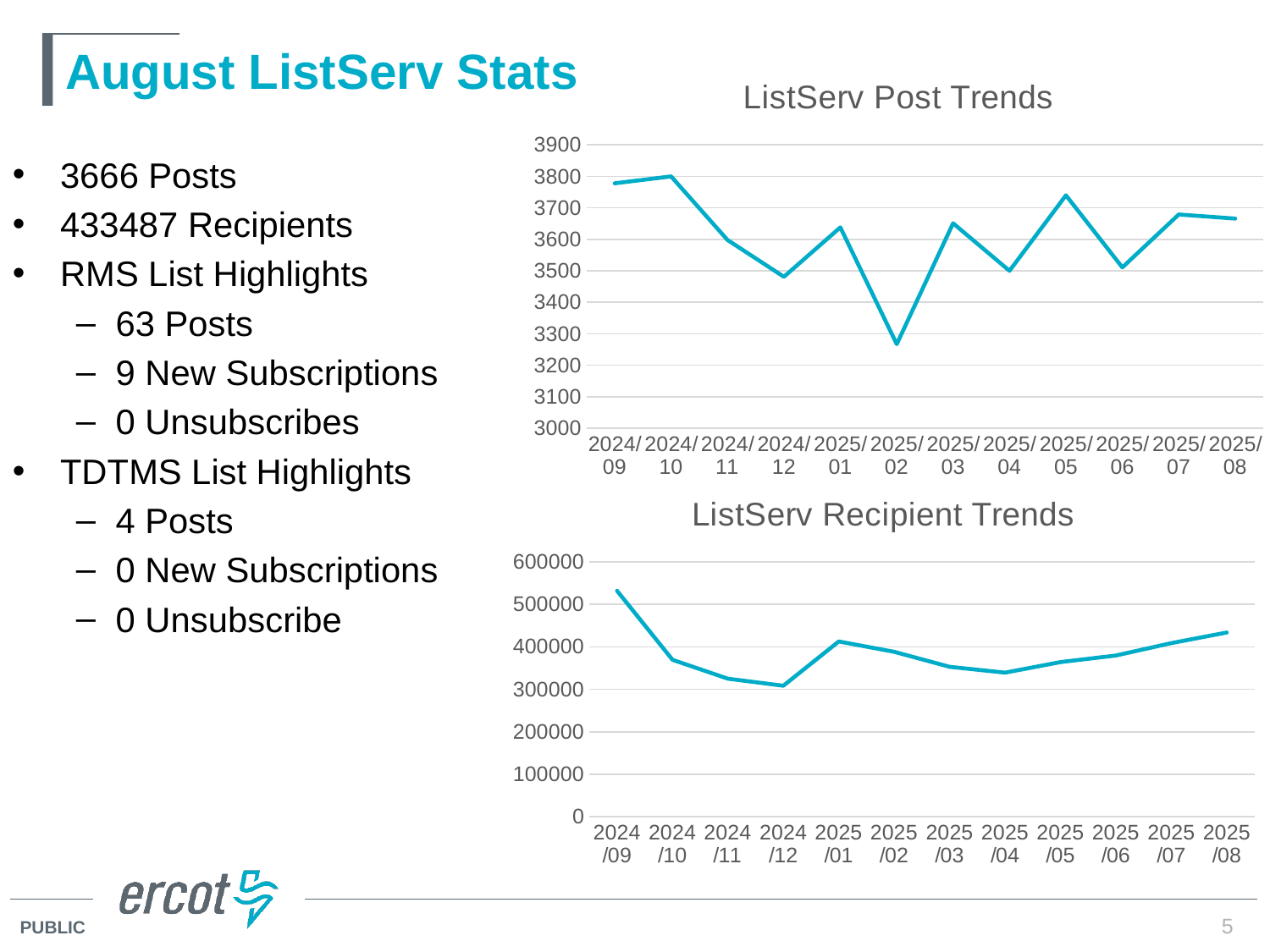
On the ListServ Post Trends chart, is the value for 2025/02 greater or less than 3300? less On the ListServ Recipient Trends chart, is the value for 2024/09 greater or less than 500000? greater On the ListServ Recipient Trends chart, do the values rise or fall from 2025/04 to 2025/08? rise On the ListServ Recipient Trends chart, is the value for 2025/04 greater or less than 400000? less On the ListServ Recipient Trends chart, which is larger, the value for 2024/09 or the value for 2025/08? 2024/09 On the ListServ Post Trends chart, which is larger, the value for 2024/09 or the value for 2025/02? 2024/09 How many data points are plotted on the ListServ Recipient Trends chart? 12 On the ListServ Recipient Trends chart, which month has the highest value? 2024/09 What kind of chart is the ListServ Post Trends chart? line chart On the ListServ Post Trends chart, which month has the lowest value? 2025/02 What is the title of the top chart on the slide? ListServ Post Trends